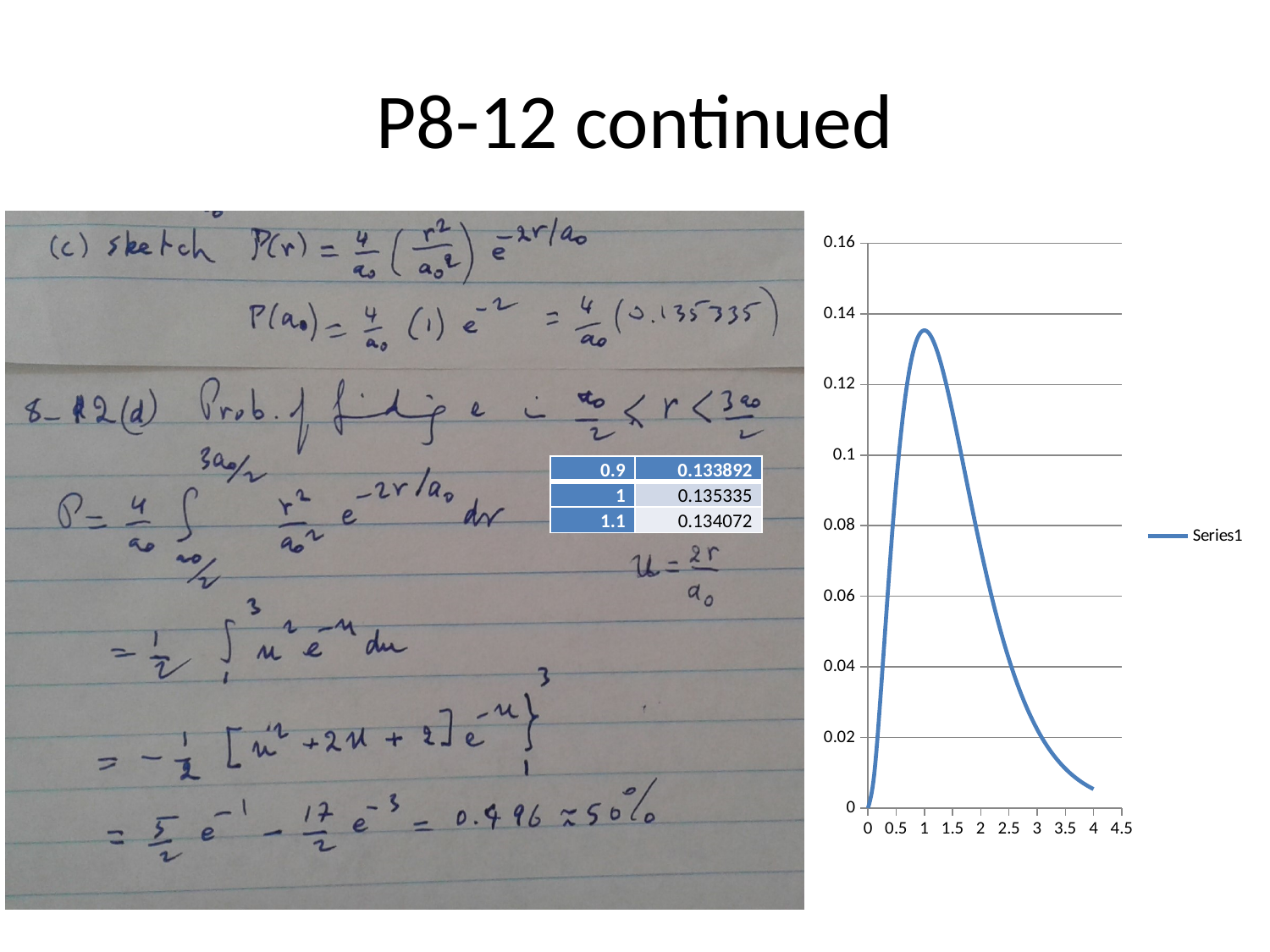
What is the name of the series shown in the chart's legend? Series1 Is the value of the curve at x = 3 greater or less than 0.04? less How many series does the chart's legend list? 1 Do the values rise or fall as x increases from 1 to 4? fall At which x-axis value does the curve reach its highest point? 1 Is the value of the curve at x = 1 greater or less than 0.12? greater Is the value of the curve at x = 2 greater or less than 0.06? greater What is the value of the curve at x = 0? 0 What is the highest tick value shown on the chart's y axis? 0.16 Do the values rise or fall as x increases from 0 to 1? rise What kind of chart is shown on the right of the slide? line chart